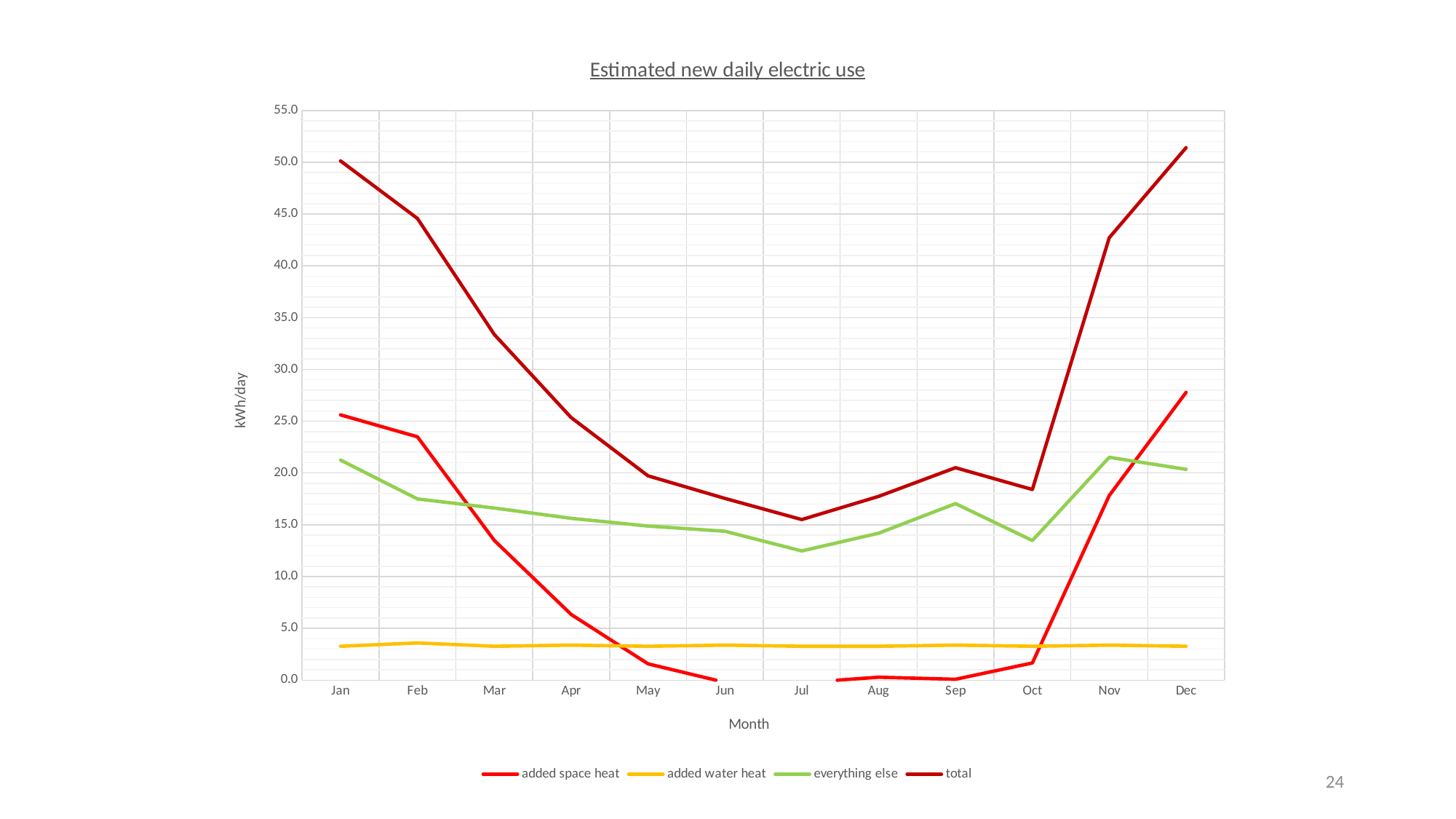
Is the value for 'added space heat' in Apr greater or less than 10.0? less In which month is the 'total' series at its lowest? Jul In which month is the 'added space heat' series at its highest? Dec In Mar, which is larger: 'everything else' or 'added space heat'? everything else Does the 'total' series rise or fall from Jan to Jul? fall What is the title of the chart? Estimated new daily electric use Is the value for 'total' in Jan greater or less than 45.0? greater How many months are plotted along the x axis? 12 What is the label on the vertical axis? kWh/day In which month is the 'everything else' series at its lowest? Jul How many series does the legend list? 4 What kind of chart is shown on the slide? line chart